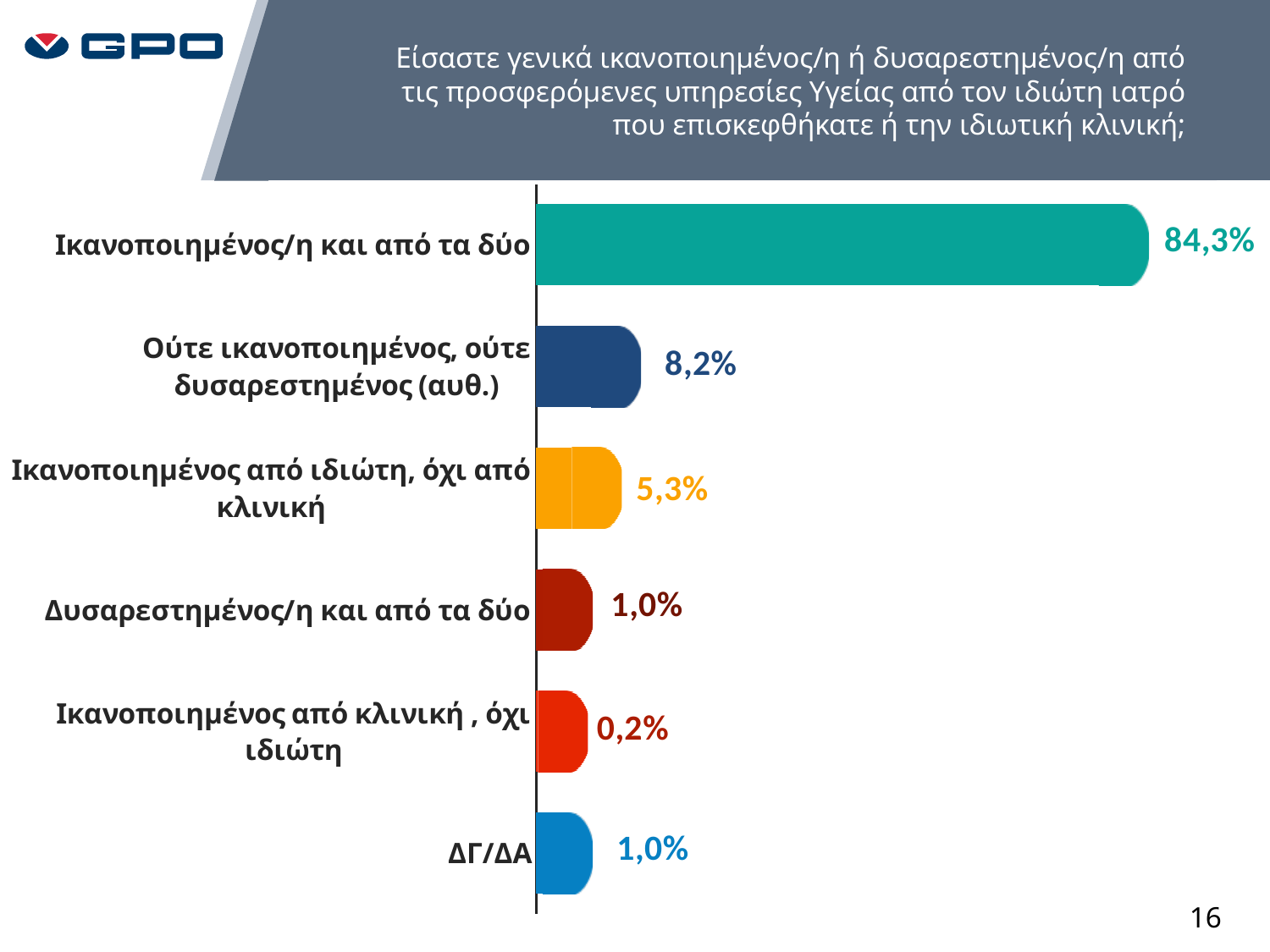
What is the value for "Ικανοποιημένος από ιδιώτη, όχι από κλινική"? 5,3% What is the value for "Ούτε ικανοποιημένος, ούτε δυσαρεστημένος (αυθ.)"? 8,2% What is the difference between "Ικανοποιημένος/η και από τα δύο" and "Ούτε ικανοποιημένος, ούτε δυσαρεστημένος (αυθ.)"? 76,1 percentage points What kind of chart is shown on the slide? Bar chart What is the value for "Ικανοποιημένος από κλινική, όχι ιδιώτη"? 0,2% Which is larger: "Ούτε ικανοποιημένος, ούτε δυσαρεστημένος (αυθ.)" or "Ικανοποιημένος από ιδιώτη, όχι από κλινική"? Ούτε ικανοποιημένος, ούτε δυσαρεστημένος (αυθ.) Which category has the lowest value? Ικανοποιημένος από κλινική, όχι ιδιώτη What is the value for "ΔΓ/ΔΑ"? 1,0% Which category has the highest value? Ικανοποιημένος/η και από τα δύο What is the value for "Ικανοποιημένος/η και από τα δύο"? 84,3% What is the difference between "Ικανοποιημένος από ιδιώτη, όχι από κλινική" and "Δυσαρεστημένος/η και από τα δύο"? 4,3 percentage points How many categories are shown in the chart? 6